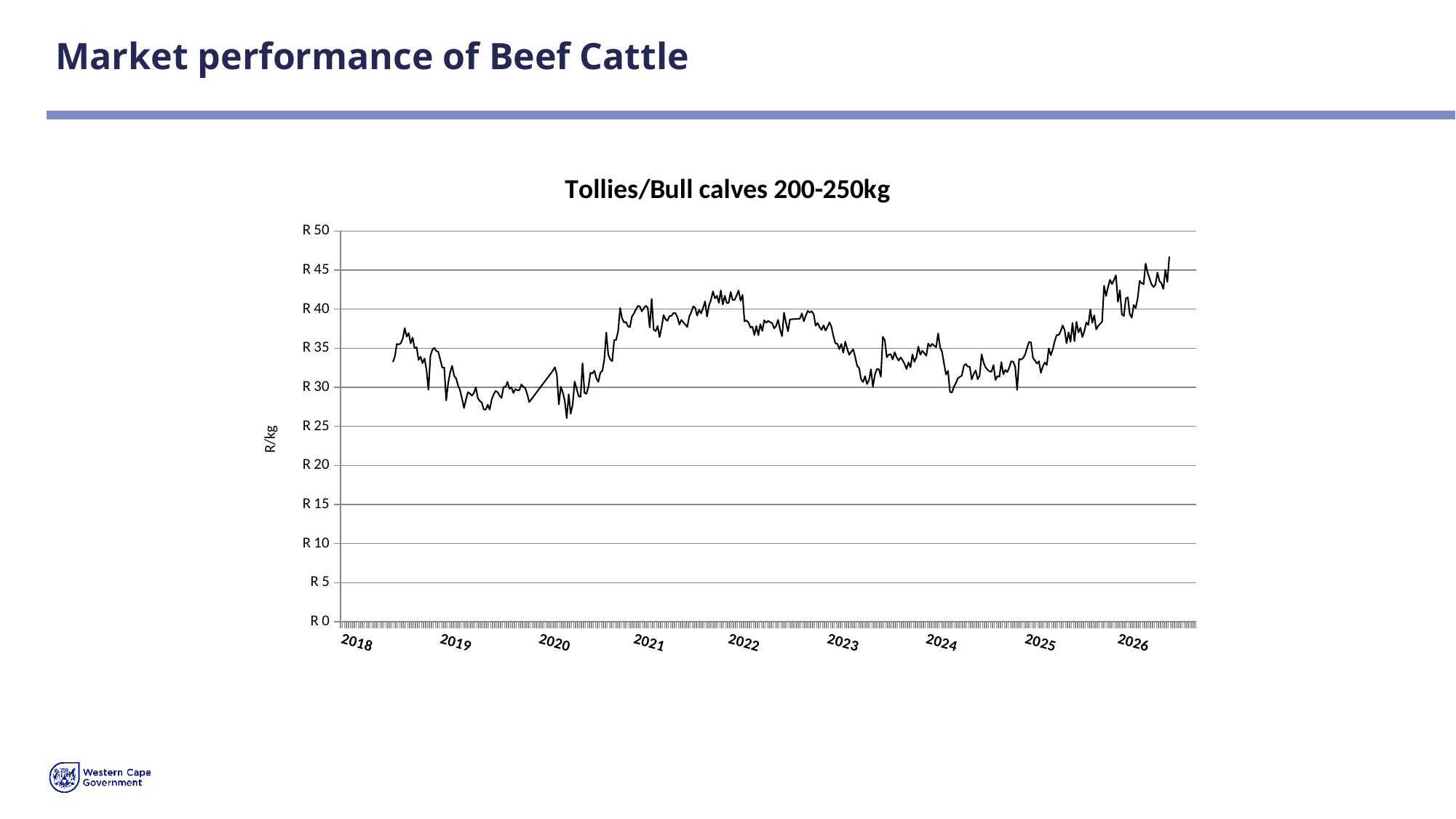
Overall, does the price rise or fall from 2018 to 2026? rise How many year labels are shown along the x axis of the chart? 9 Is the lowest value reached around 2020 greater or less than R 30? less Is the value in 2026 larger or smaller than the value in 2018? larger Is the peak value reached around 2022 greater or less than R 40? greater Is the value at the start of the series in 2018 greater or less than R 30? greater What is the label on the vertical axis of the chart? R/kg What is the title of the chart? Tollies/Bull calves 200-250kg What kind of chart is shown on the slide? line chart In which year does the series reach its highest value? 2026